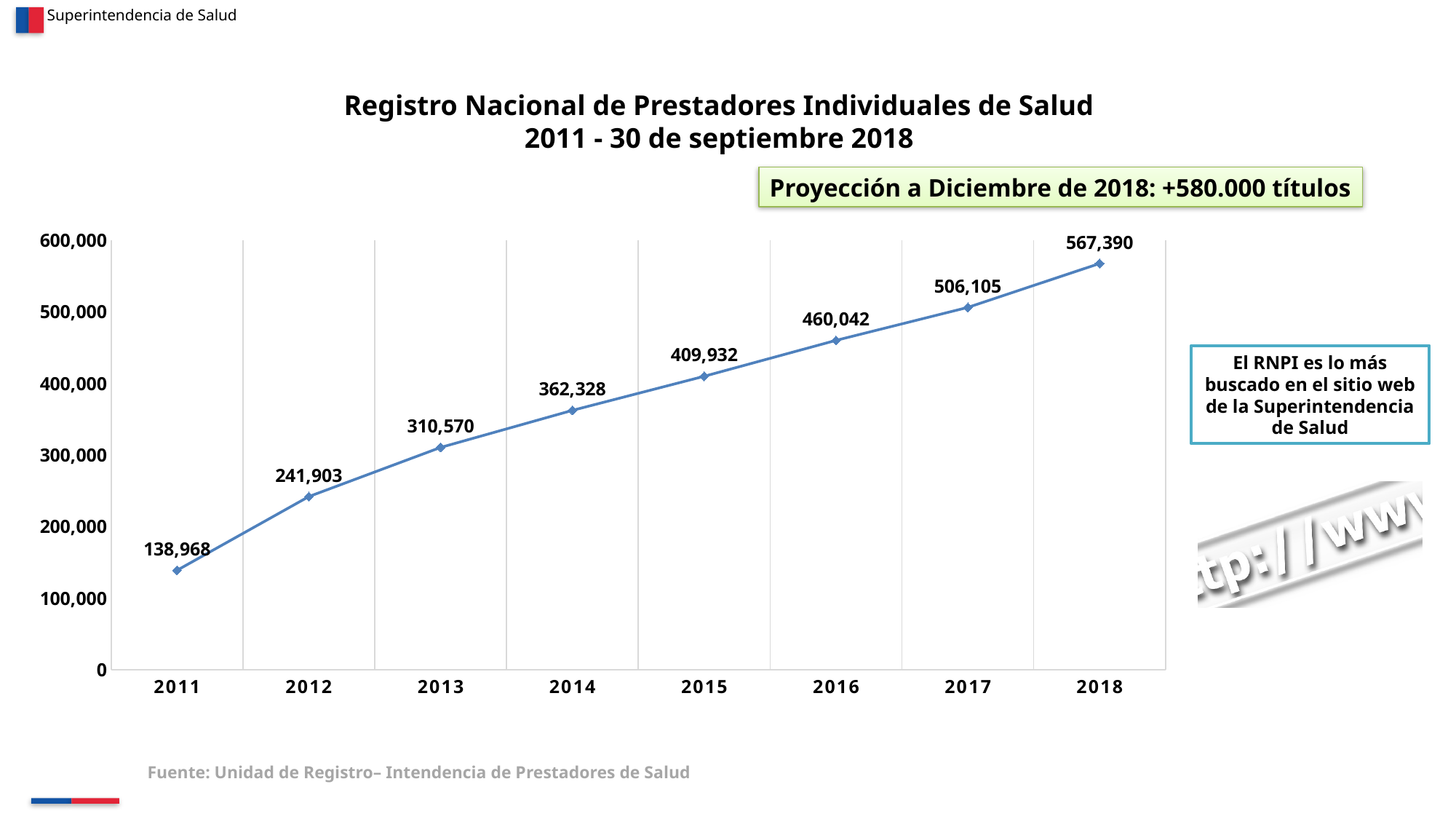
What is the value for 2015? 409,932 Is the value for 2016 greater or less than 400,000? greater What kind of chart is shown? line chart Which year has the lowest value? 2011 Which year has the highest value? 2018 What is the difference between the values for 2018 and 2017? 61,285 What is the value for 2011? 138,968 What is the value for 2018? 567,390 How many years are plotted on the chart? 8 Do the values rise or fall from 2011 to 2018? rise What is the difference between the values for 2012 and 2011? 102,935 Which is larger, the value for 2013 or the value for 2014? 2014